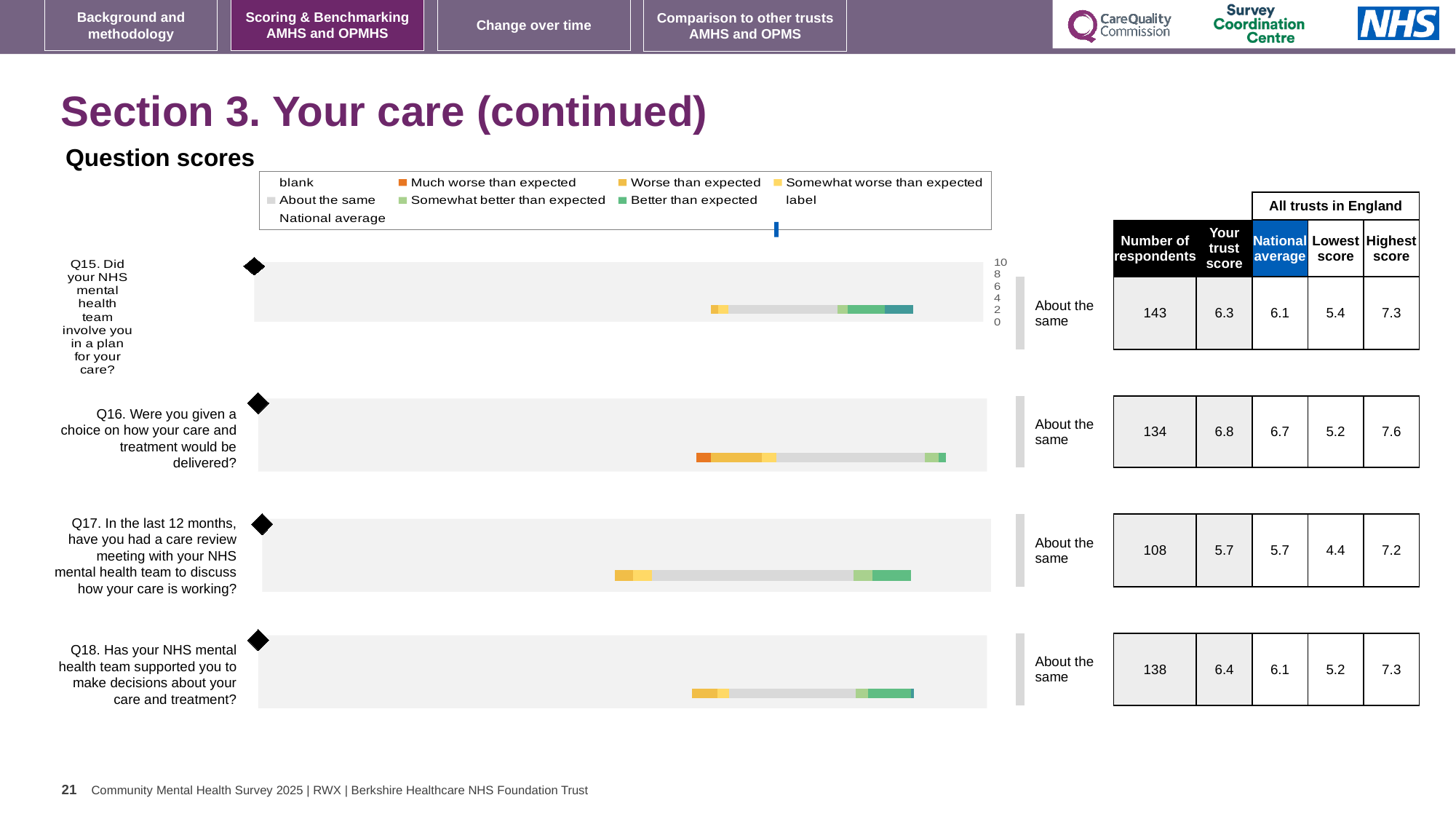
How many questions (Q15 to Q18) are plotted on the slide? 4 For Q17, what is the difference between the highest score and the lowest score among all trusts in England? 2.8 How many respondents are recorded for Q17 (care review meeting in the last 12 months)? 108 Which question has the highest 'Your trust score' on the slide? Q16 Which question has the lowest 'Your trust score' on the slide? Q17 What is the highest score among all trusts in England for Q15? 7.3 For Q15, which is larger: the trust score or the national average? the trust score What is the 'Your trust score' value for Q16 (Were you given a choice on how your care and treatment would be delivered?)? 6.8 What kind of chart is used to show the question scores for Q15 to Q18? bar chart What benchmark category label is shown next to the Q18 bar? About the same For Q18, what is the difference between the trust score and the national average? 0.3 What is the lowest score among all trusts in England for Q16? 5.2